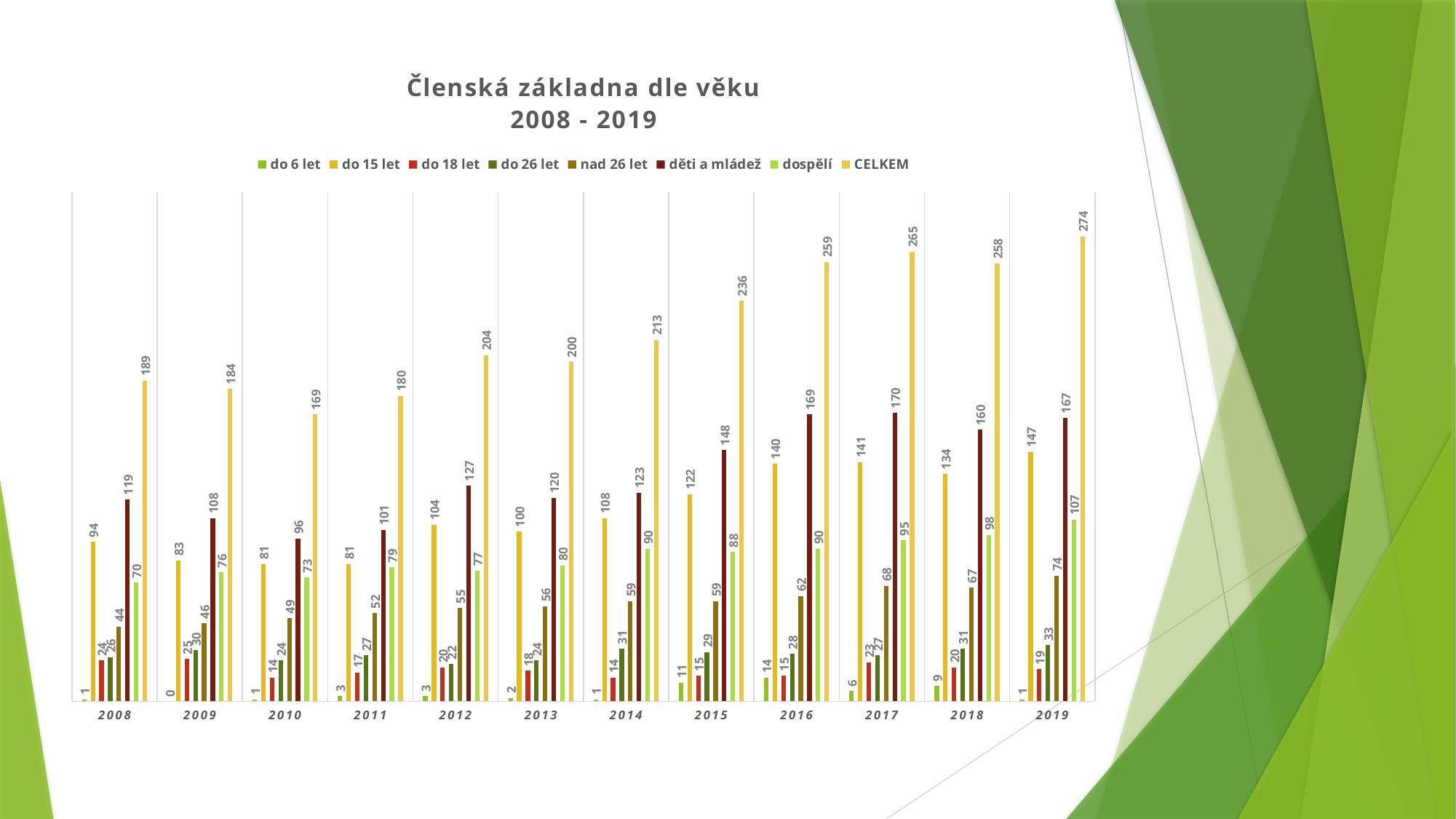
Does the CELKEM value rise or fall from 2013 to 2017? rise In which year is the CELKEM value lowest? 2010 What is the value for 'děti a mládež' in 2016? 169 What is the difference between the CELKEM values for 2017 and 2008? 76 What is the CELKEM value for 2019? 274 What is the title of the chart? Členská základna dle věku 2008 - 2019 How many series does the legend list? 8 How many years are shown on the x axis? 12 What is the value for 'dospělí' in 2008? 70 Which is larger: the 'do 15 let' value in 2017 or in 2018? 2017 What kind of chart is shown on the slide? bar chart In which year is the CELKEM value highest? 2019